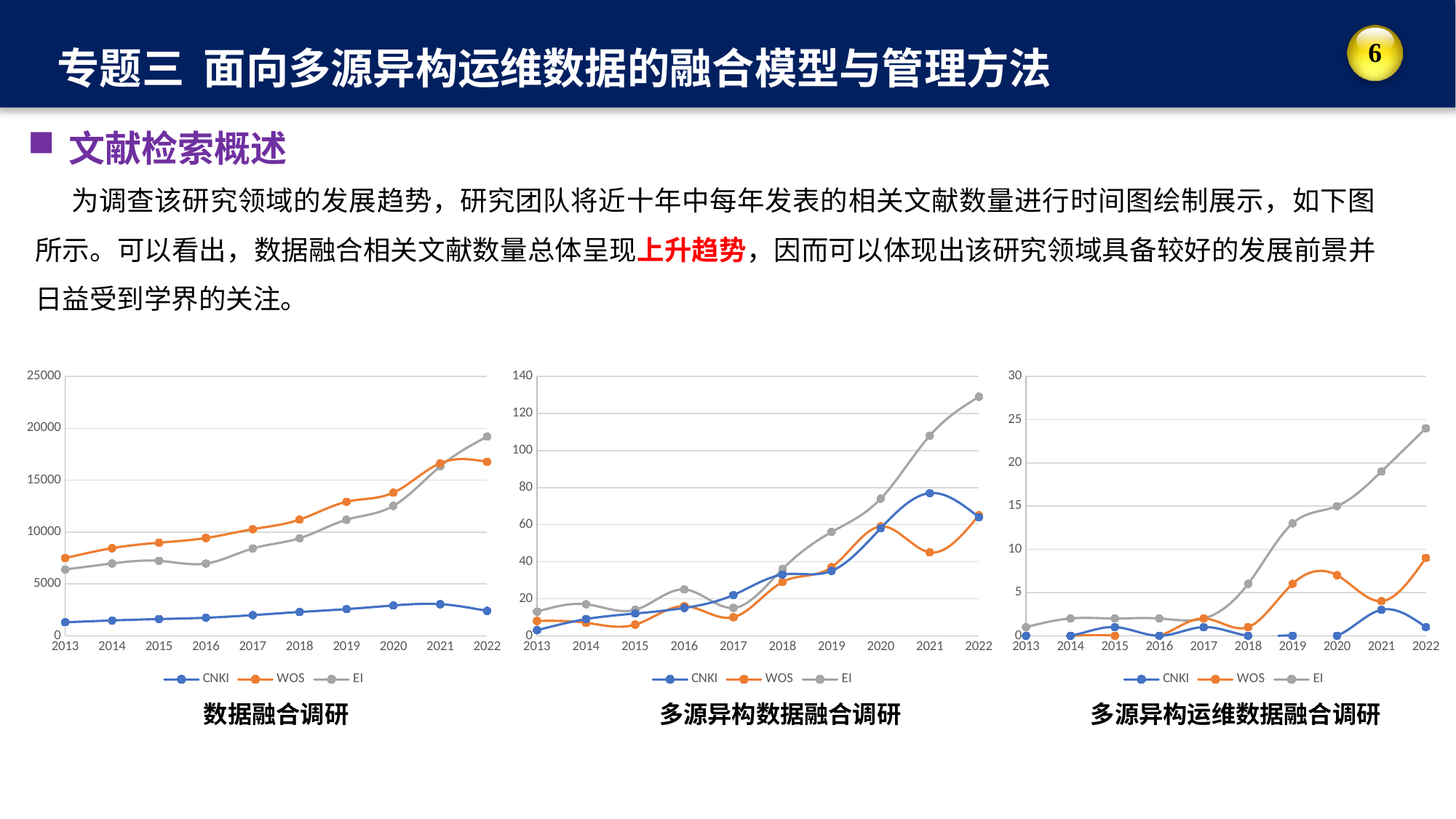
In the 多源异构数据融合调研 chart, which is larger in 2021, CNKI or WOS? CNKI In the 数据融合调研 chart, which series has the highest value in 2022? EI In the 数据融合调研 chart, which series has the lowest value in 2022? CNKI In the 多源异构数据融合调研 chart, is the value for EI in 2022 greater or less than 120? greater In the 数据融合调研 chart, is the value for EI in 2022 greater or less than 15000? greater How many series does the legend of the 多源异构数据融合调研 chart list? 3 In the 多源异构运维数据融合调研 chart, is the value for EI in 2022 greater or less than 20? greater What kind of chart is the 数据融合调研 chart? line chart How many years are shown on the x axis of the 多源异构运维数据融合调研 chart? 10 In the 多源异构运维数据融合调研 chart, which series has the highest value in 2022? EI In the 数据融合调研 chart, does the WOS series generally rise or fall from 2013 to 2022? rise